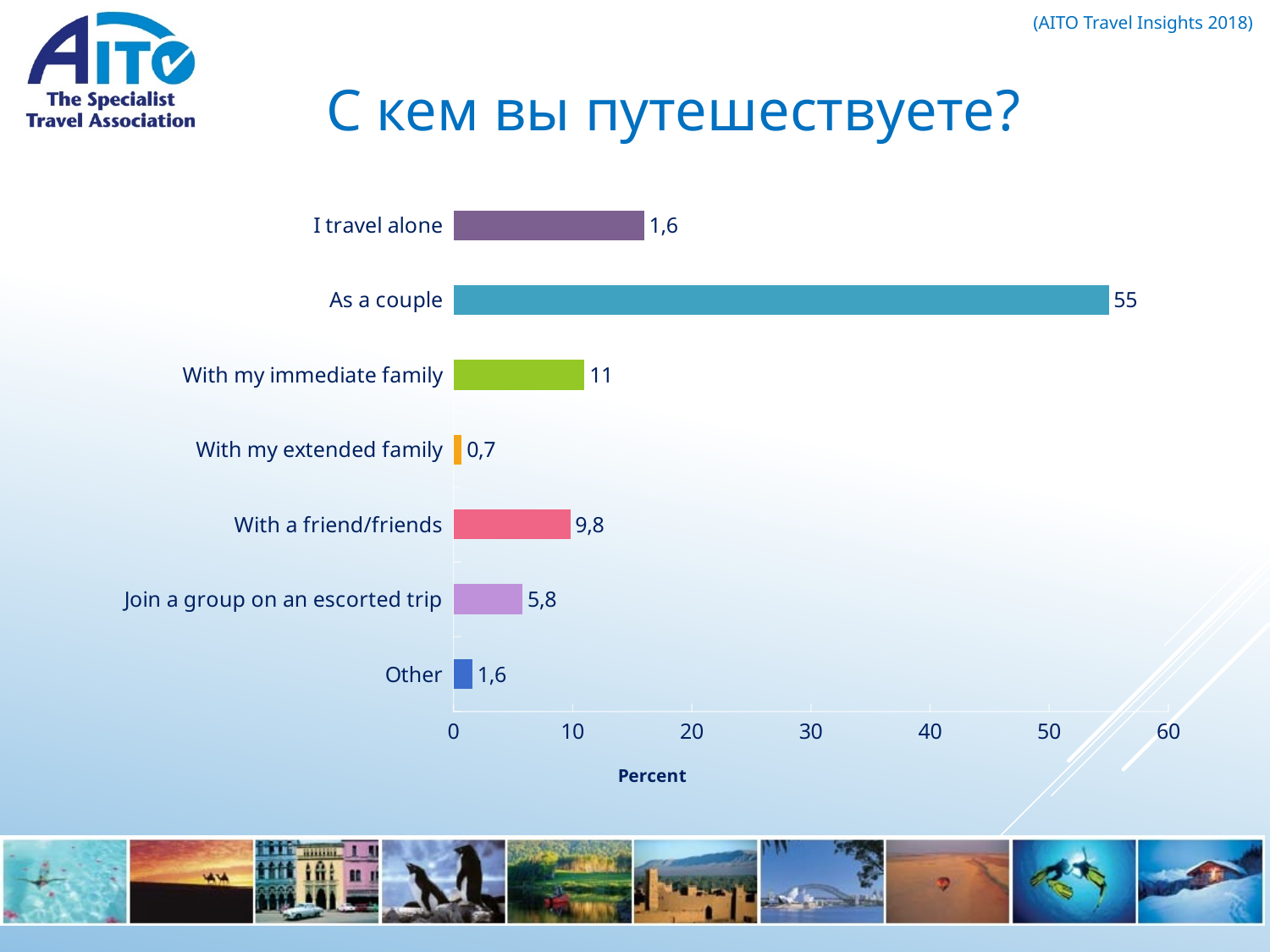
What is the value for "Join a group on an escorted trip"? 5,8 Which category has the lowest value? With my extended family Which category has the highest value? As a couple Which is larger, the value for "With a friend/friends" or for "Join a group on an escorted trip"? With a friend/friends What is the difference between the values for "As a couple" and "With my immediate family"? 44 How many categories are shown in the chart? 7 What is the value for "With my immediate family"? 11 What is the value for "With a friend/friends"? 9,8 What is the value for "As a couple"? 55 What is the value for "With my extended family"? 0,7 What type of chart is shown on the slide? bar chart What is the label of the horizontal axis? Percent